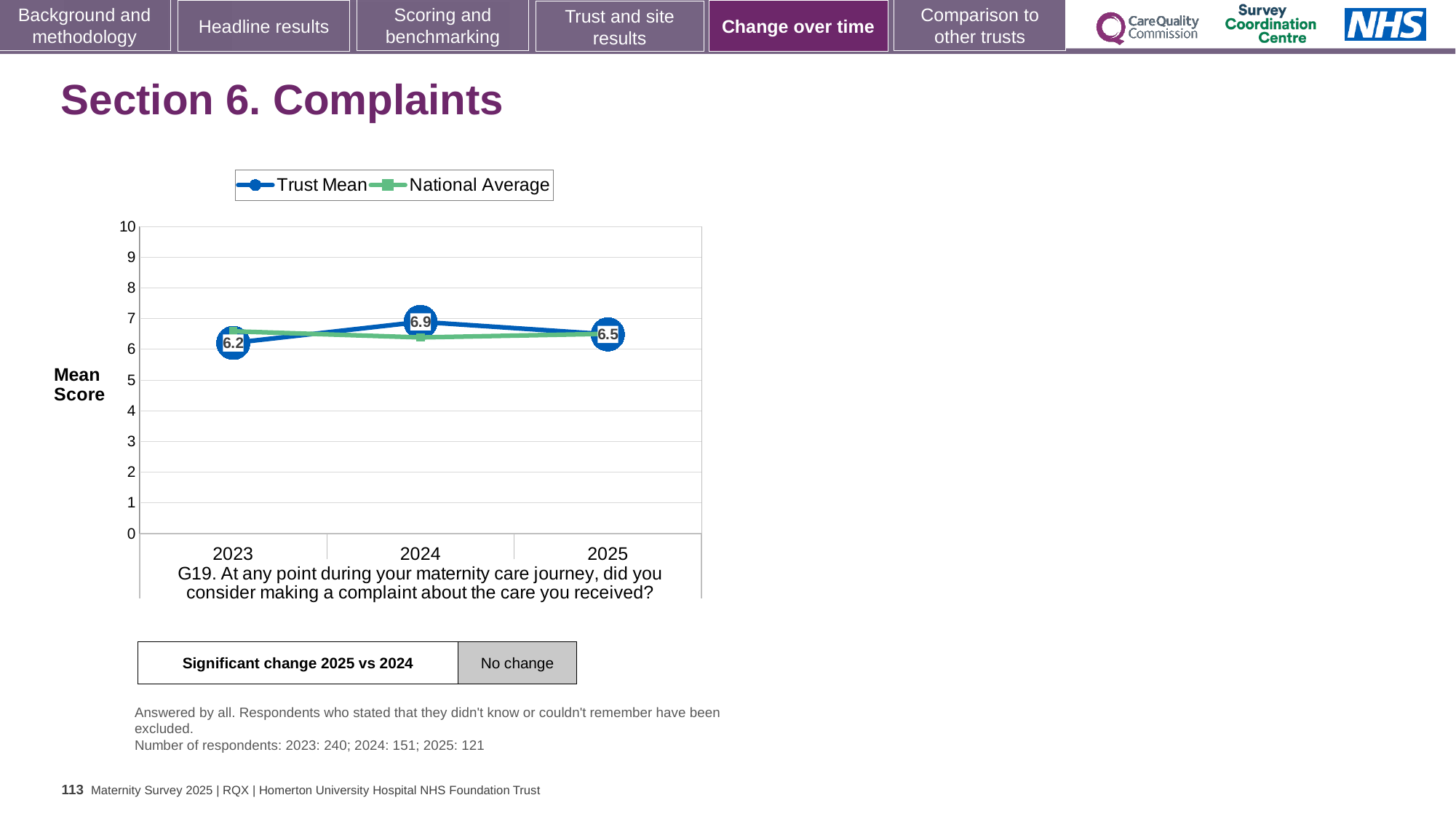
What is the Trust Mean value for 2025? 6.5 Is the National Average value for 2024 greater or less than 5? greater What is the Trust Mean value for 2023? 6.2 How many series does the legend list? 2 What is the Trust Mean value for 2024? 6.9 How many years are plotted on the x axis? 3 In which year is the Trust Mean lowest? 2023 Which year has the larger Trust Mean, 2023 or 2025? 2025 What kind of chart is shown on the slide? Line chart What is the label on the y axis of the chart? Mean Score What is the difference between the Trust Mean in 2024 and in 2023? 0.7 In which year is the Trust Mean highest? 2024